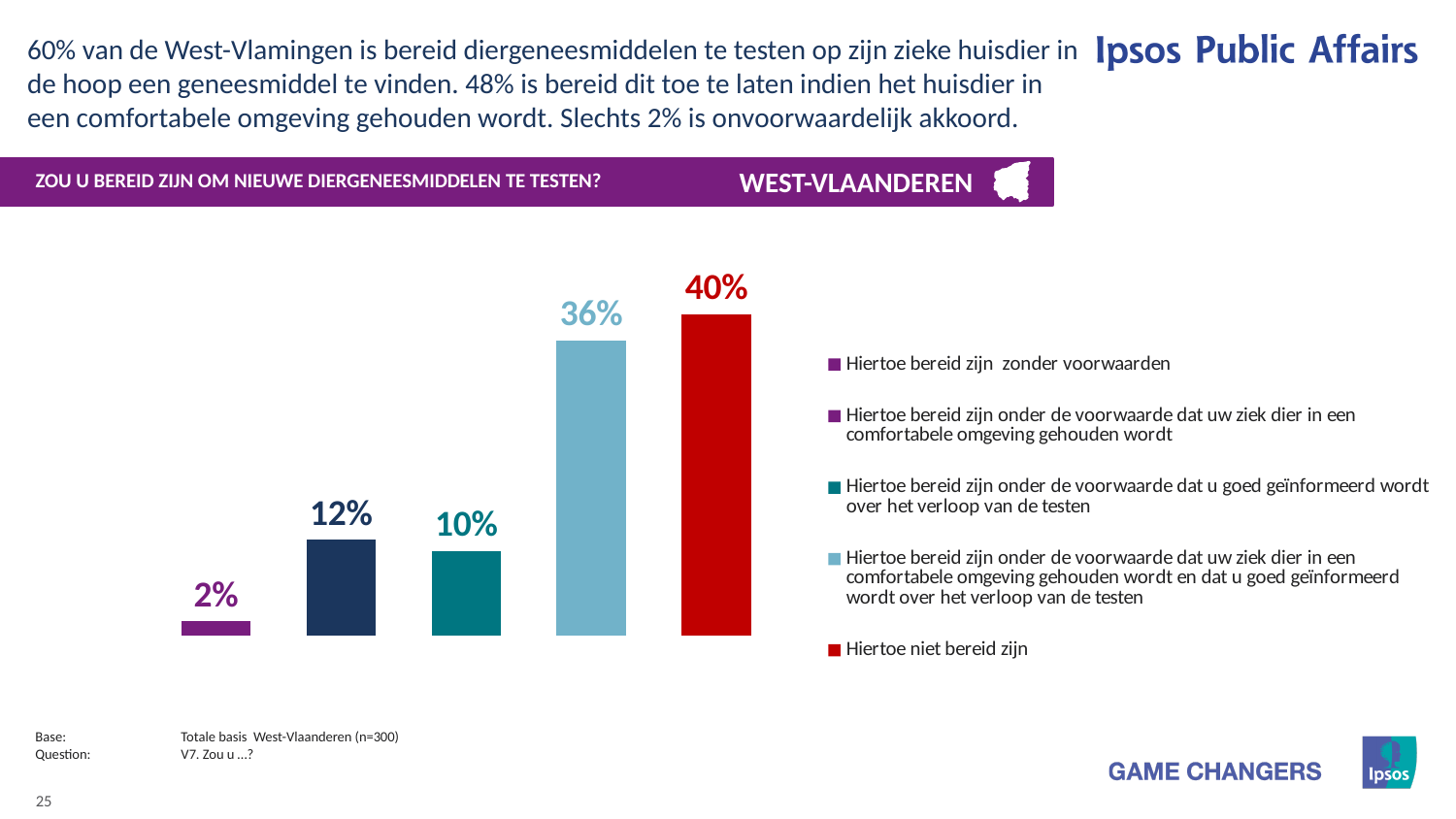
What percentage of respondents are not willing to test new veterinary medicines ("Hiertoe niet bereid zijn")? 40% How many entries does the legend list? 5 What is the combined value of the dark navy bar (12%) and the teal bar (10%)? 22% What is the value for the teal bar, representing those willing on the condition that they are well informed about the course of the tests? 10% What type of chart is shown on the slide? Bar chart Which is larger: the dark navy bar (comfortable environment condition) or the teal bar (well informed condition)? The dark navy bar (12%) How many bars are plotted in the chart? 5 What is the value for the light blue bar, representing those willing on the condition that the pet is kept in a comfortable environment and they are well informed about the tests? 36% Which response category has the lowest value in the chart? Hiertoe bereid zijn zonder voorwaarden What is the difference between the value for "Hiertoe niet bereid zijn" and the value for the light blue bar (comfortable environment and well informed)? 4% Which response category has the highest value in the chart? Hiertoe niet bereid zijn What percentage of respondents are willing to test new veterinary medicines without conditions ("Hiertoe bereid zijn zonder voorwaarden")? 2%